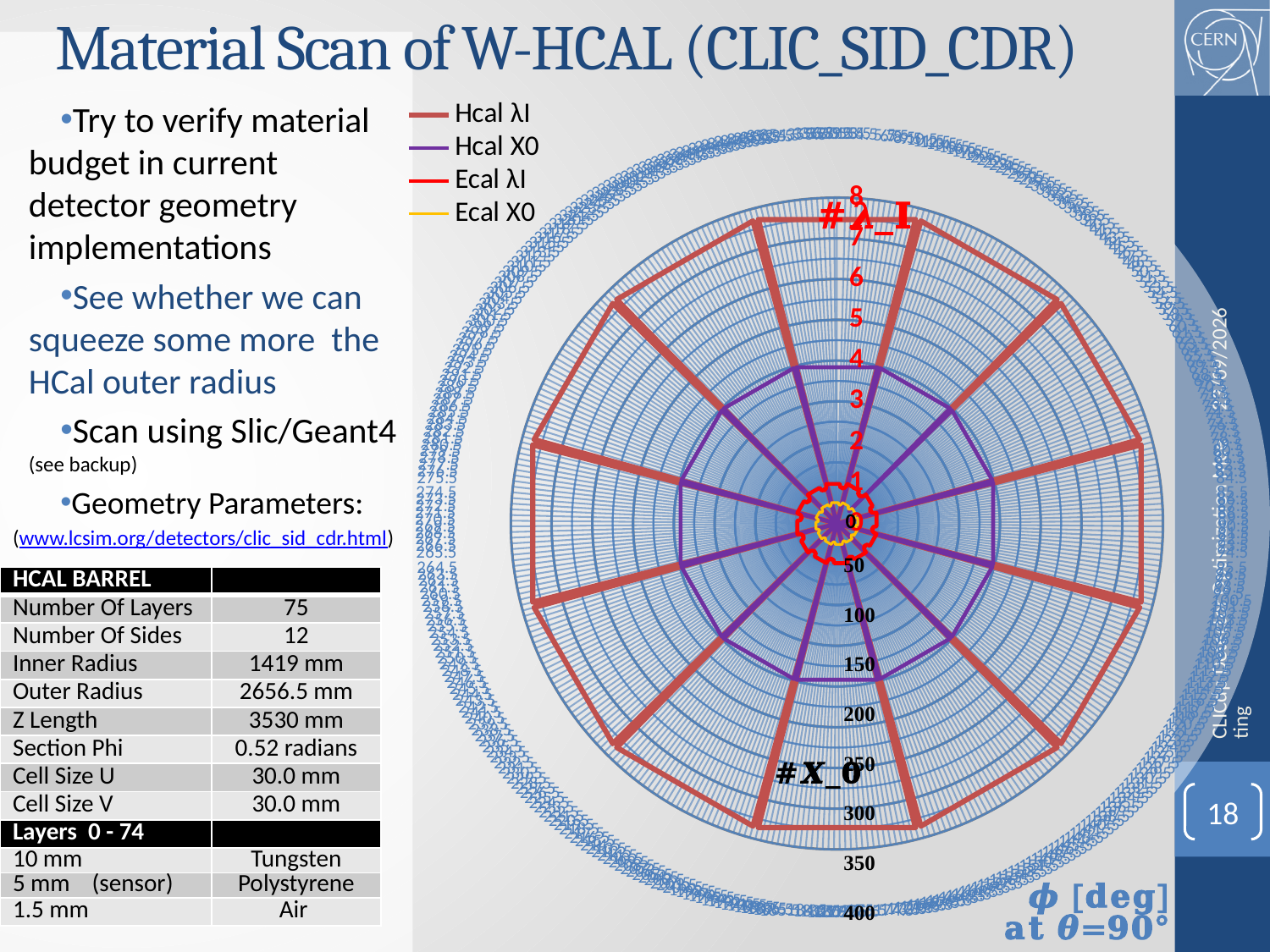
Which series are listed in the chart legend? Hcal λI, Hcal X0, Ecal λI, Ecal X0 What is the highest tick value shown on the λI radial axis of the chart? 8 Is the value of the Hcal λI series greater or less than 4 on the λI axis? greater Is the value of the Ecal λI series greater or less than 2 on the λI axis? less How many series does the chart legend list? 4 What kind of chart is shown on the slide? Radar chart Which series has the larger X0 value, Hcal X0 or Ecal X0? Hcal X0 Which series has the larger λI value, Hcal λI or Ecal λI? Hcal λI Which series extends furthest from the centre of the radar chart? Hcal λI